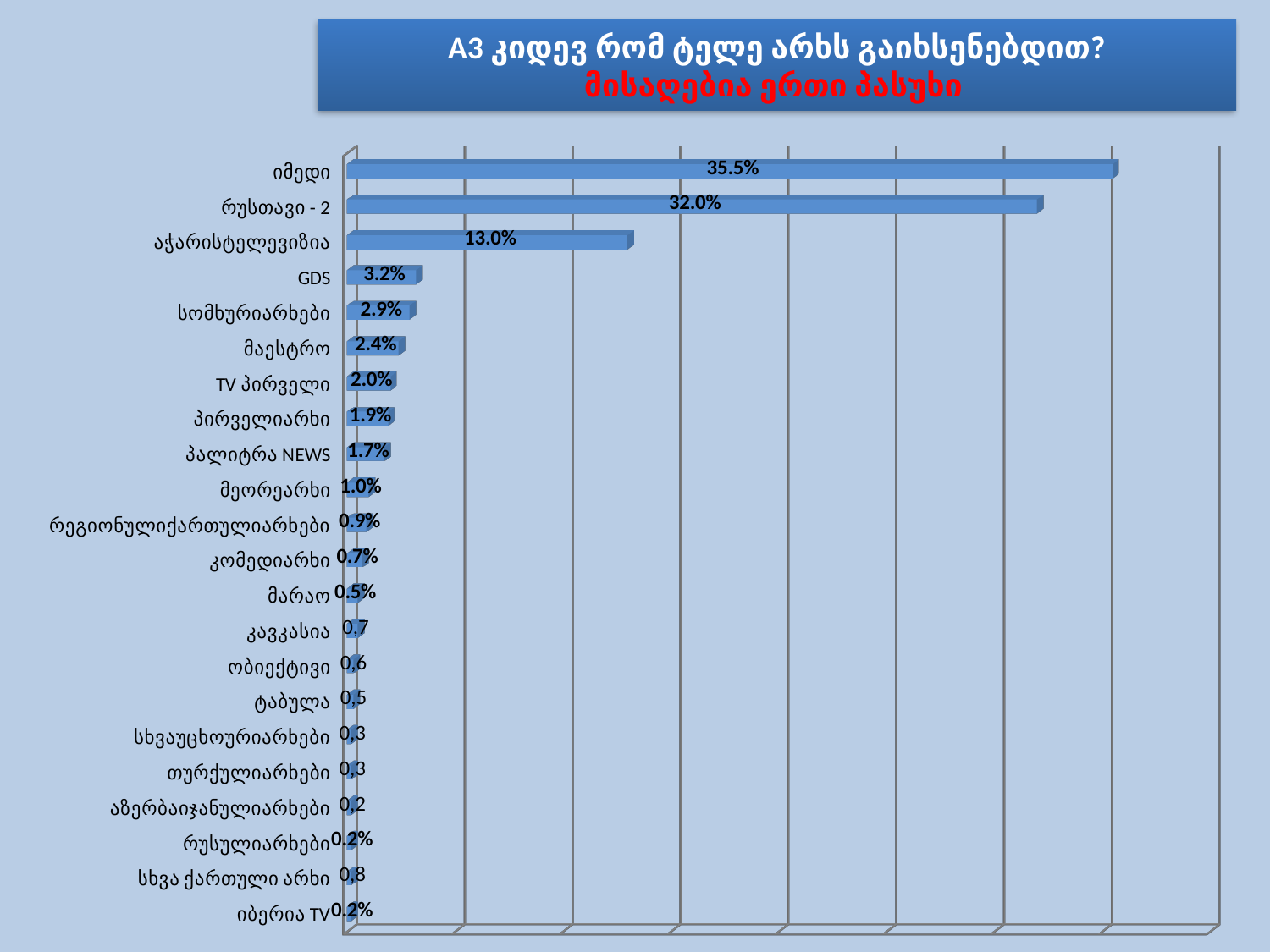
Which is larger, the value for სომხურიარხები or the value for TV პირველი? სომხურიარხები What is the value for რუსთავი - 2? 32.0% What is the value for პალიტრა NEWS? 1.7% What kind of chart is shown on the slide? Bar chart What is the value for GDS? 3.2% Which category has the highest value? იმედი What is the difference between the values for აჭარისტელევიზია and GDS? 9.8% How many categories are shown in the chart? 22 What is the difference between the values for იმედი and რუსთავი - 2? 3.5% What is the value for მაესტრო? 2.4% What is the value for აჭარისტელევიზია? 13.0% What is the value for იმედი? 35.5%